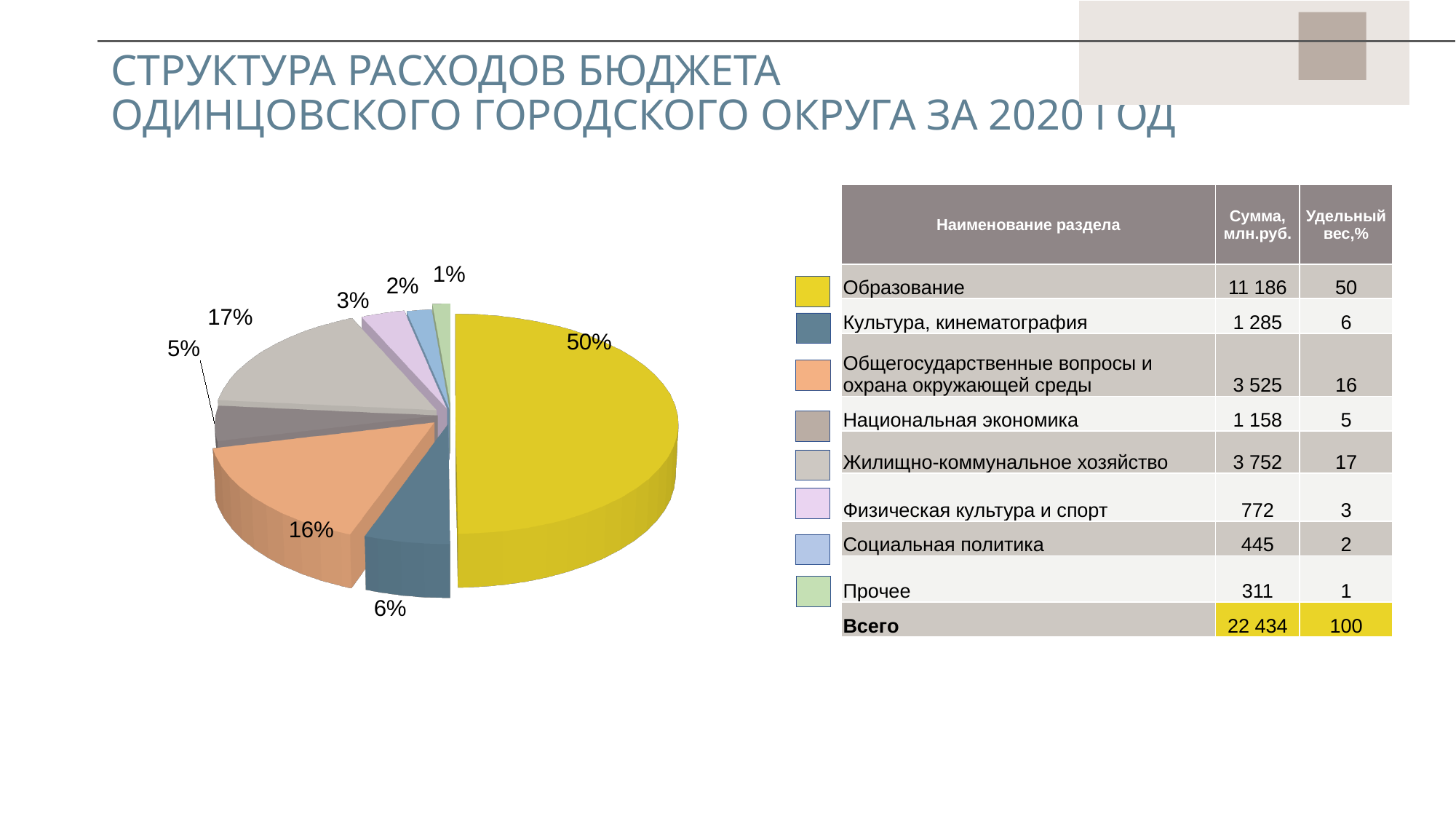
What share of the pie does the Прочее slice represent? 1% How many slices does the pie chart have? 8 What is the difference in percentage points between the Образование slice and the Жилищно-коммунальное хозяйство slice? 33 What share of the pie does the Культура, кинематография slice represent? 6% Which category has the largest slice of the pie? Образование Which slice is larger: Национальная экономика or Физическая культура и спорт? Национальная экономика What share of the pie does the Жилищно-коммунальное хозяйство slice represent? 17% Which category has the smallest slice of the pie? Прочее What kind of chart is shown on the slide? pie chart What colour is the slice representing Социальная политика? light blue